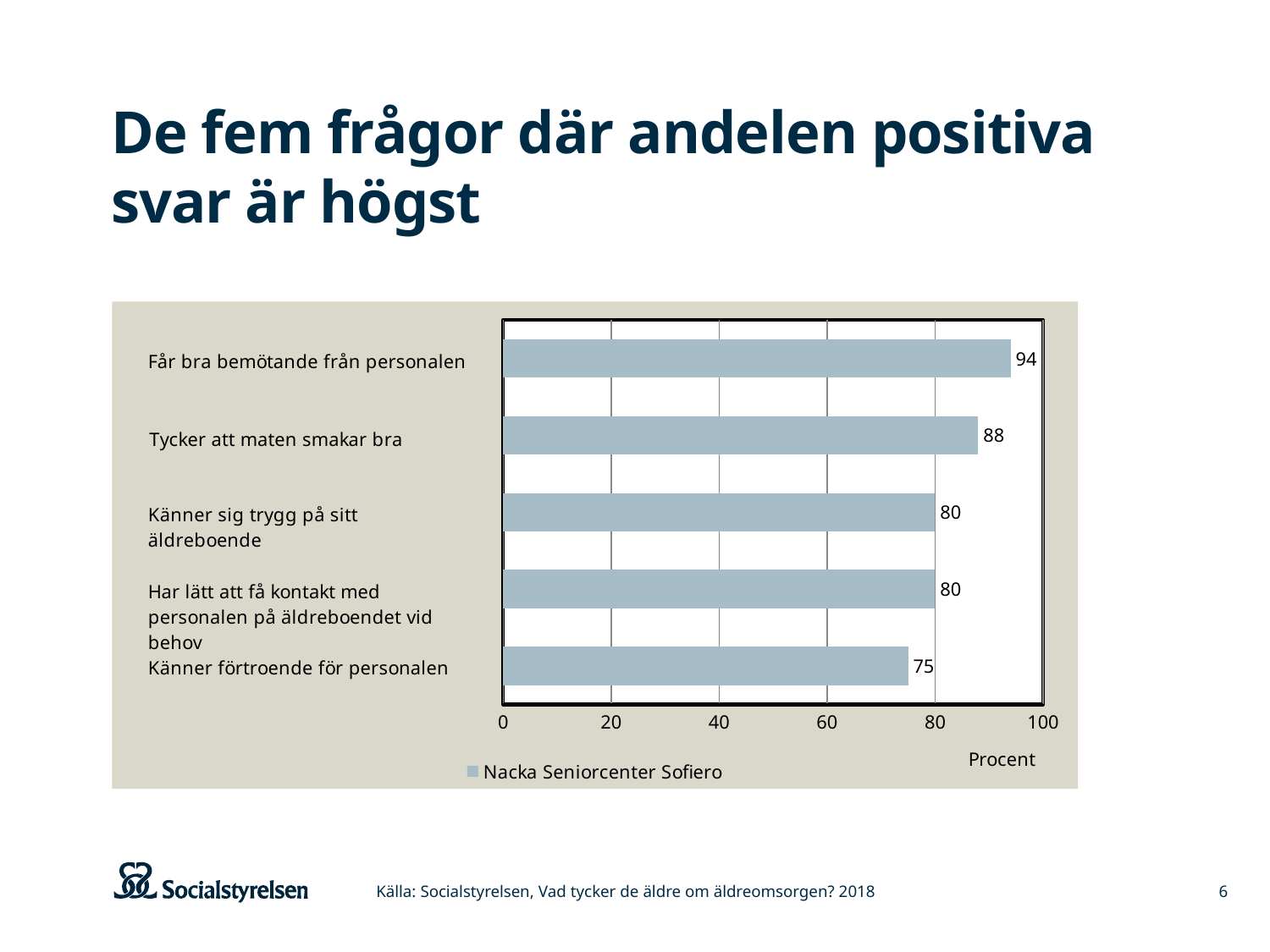
Which category has the highest value? Får bra bemötande från personalen What is the value for "Tycker att maten smakar bra"? 88 What is the value for "Känner förtroende för personalen"? 75 What is the difference between the values for "Tycker att maten smakar bra" and "Känner sig trygg på sitt äldreboende"? 8 What is the value for "Får bra bemötande från personalen"? 94 What kind of chart is shown on the slide? Bar chart Which is larger: the value for "Tycker att maten smakar bra" or the value for "Känner förtroende för personalen"? Tycker att maten smakar bra Which category has the lowest value? Känner förtroende för personalen What is the value for "Känner sig trygg på sitt äldreboende"? 80 How many categories are shown in the chart? 5 What is the difference between the values for "Får bra bemötande från personalen" and "Känner förtroende för personalen"? 19 What series does the legend list? Nacka Seniorcenter Sofiero